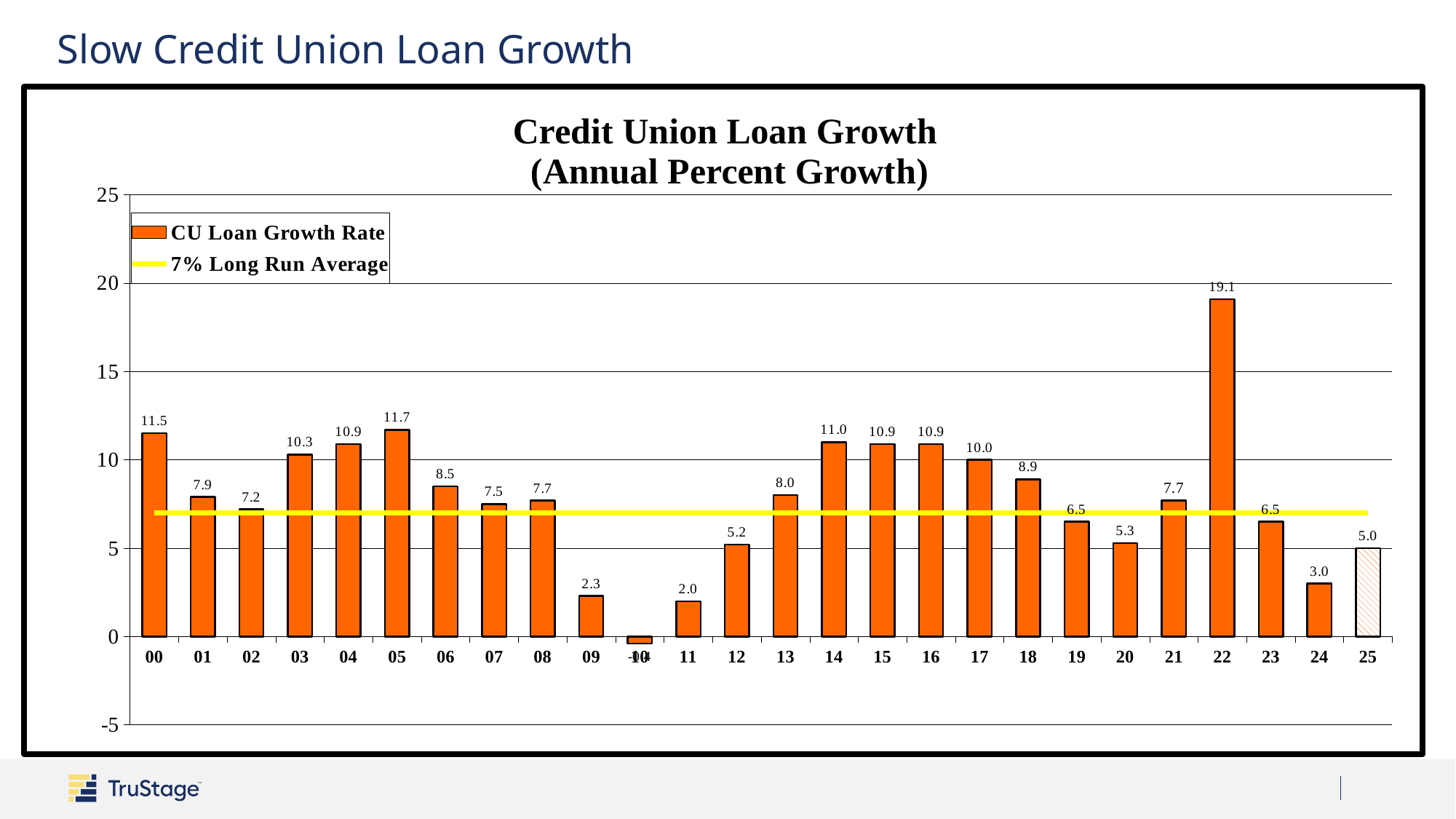
Which year has the lowest CU Loan Growth Rate? 10 How many years are shown on the x axis? 26 Is the CU Loan Growth Rate for 24 greater or less than 5? less What is the CU Loan Growth Rate for 25? 5.0 Which year has a higher CU Loan Growth Rate, 14 or 17? 14 What value does the yellow line in the chart represent? 7% Long Run Average How many series does the legend list? 2 Which year has the highest CU Loan Growth Rate? 22 What is the CU Loan Growth Rate for 22? 19.1 What is the difference between the CU Loan Growth Rate for 22 and for 23? 12.6 What is the CU Loan Growth Rate for 05? 11.7 What kind of chart is shown? combination bar and line chart